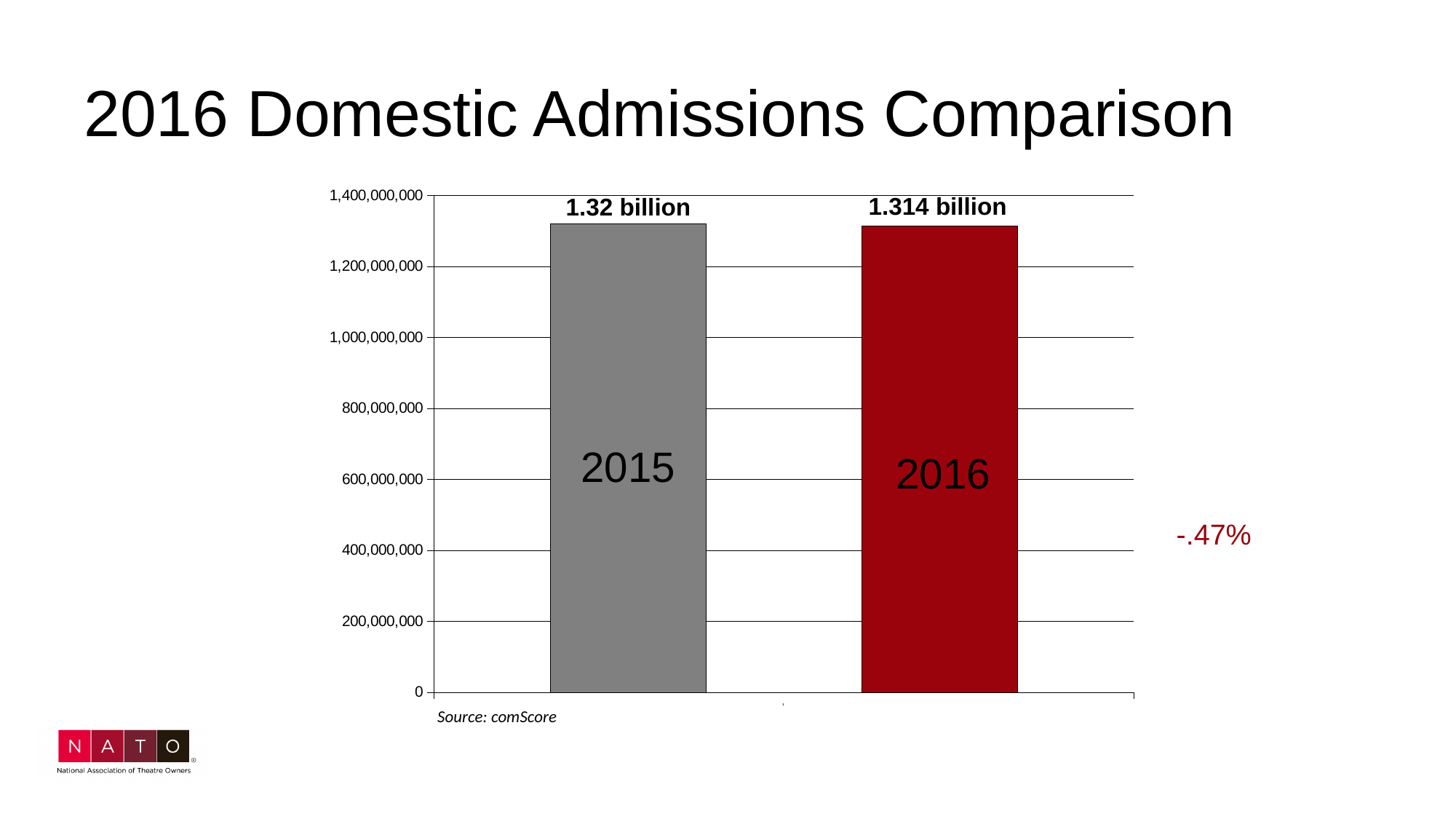
Is the value for 2015 greater or less than 1,400,000,000? less Which year has the higher admissions value? 2015 Is the value for 2016 greater or less than 1,200,000,000? greater What is the value for 2015? 1.32 billion What is the title of the slide? 2016 Domestic Admissions Comparison What is the source cited for the chart? comScore What is the value for 2016? 1.314 billion Do the values rise or fall from 2015 to 2016? fall Which year has the lower admissions value? 2016 What kind of chart is shown on the slide? bar chart How many bars are shown in the chart? 2 What percentage change is shown next to the chart? -.47%